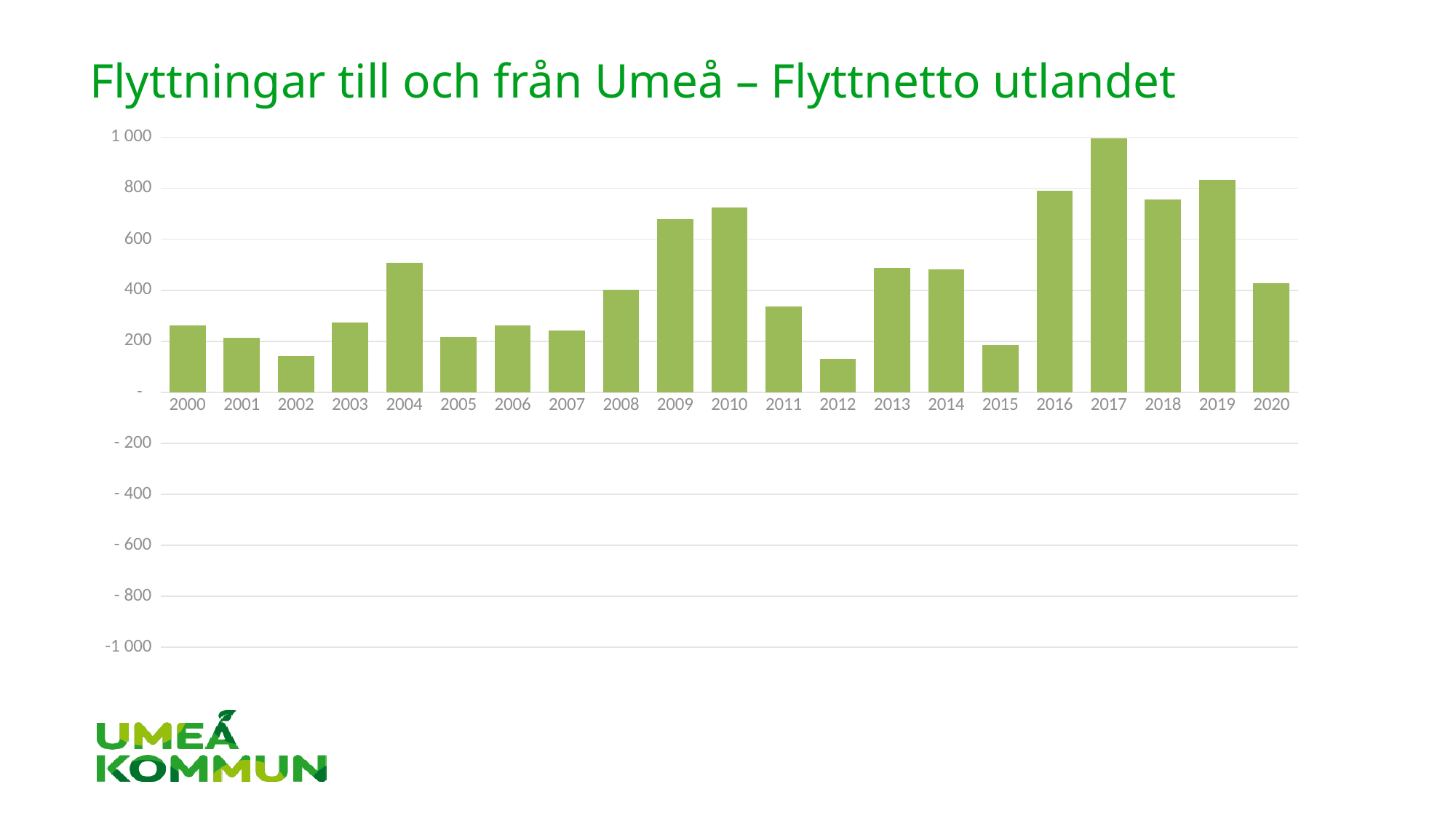
Which year has the larger value, 2016 or 2020? 2016 What kind of chart is shown on the slide? bar chart How many years are shown on the x axis of the chart? 21 Is the value for 2010 greater or less than 600? greater What is the title of the chart? Flyttningar till och från Umeå – Flyttnetto utlandet Is the value for 2012 greater or less than 200? less Which year has the highest value in the chart? 2017 Which year has the larger value, 2018 or 2019? 2019 Is the value for 2017 greater or less than 800? greater Do the values rise or fall from 2015 to 2017? rise